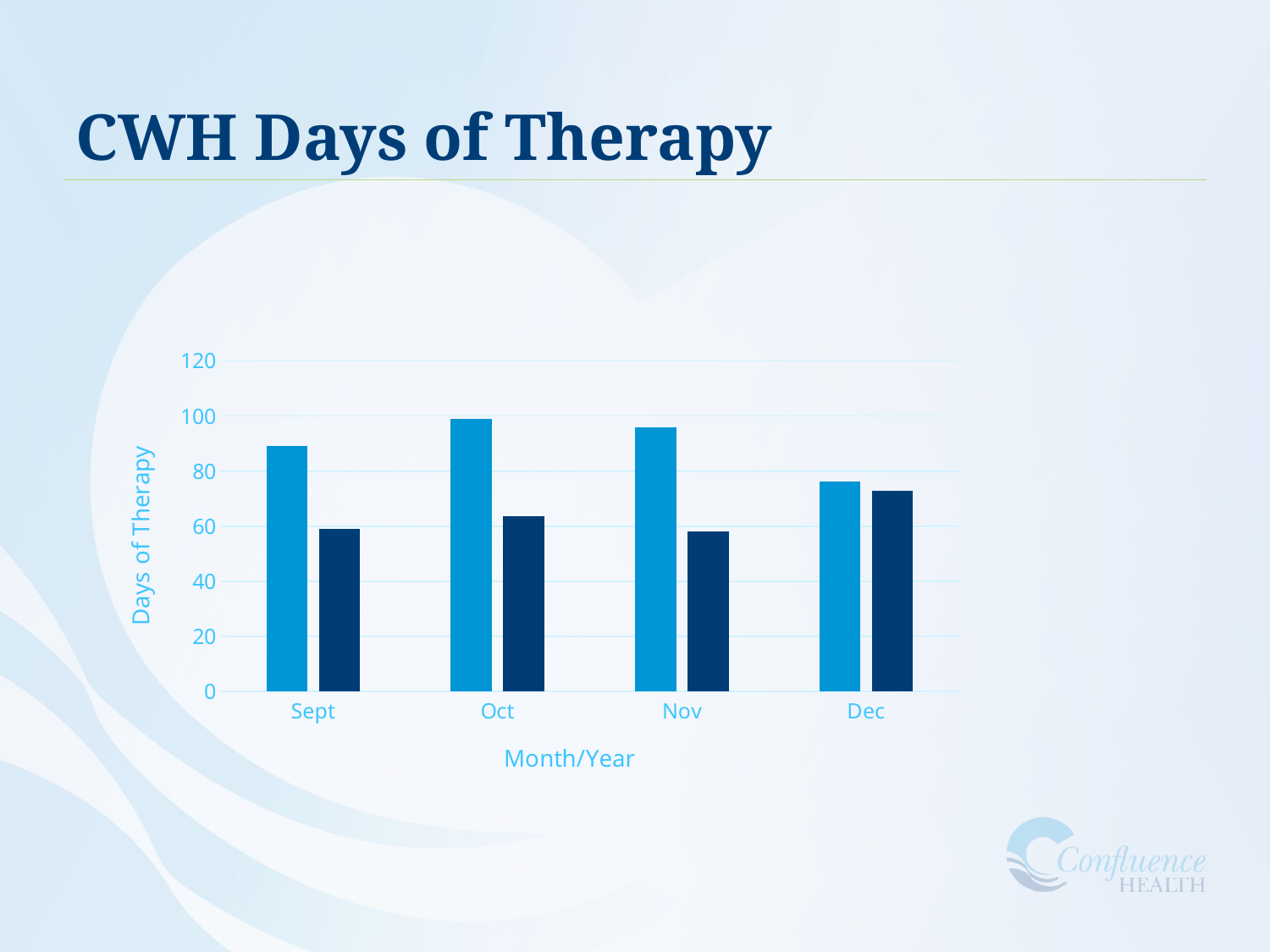
For Nov, which bar is larger, the light blue bar or the dark blue bar? light blue What kind of chart is shown on the slide? bar chart What is the label on the vertical axis of the chart? Days of Therapy In which month is the dark blue bar the highest? Dec Is the light blue bar for Oct greater or less than 80? greater Is the light blue bar for Dec greater or less than 80? less How many bars are plotted for each month in the chart? 2 Do the light blue bars rise or fall from Oct to Dec? fall How many months are shown on the x axis of the chart? 4 In which month is the light blue bar the lowest? Dec Is the dark blue bar for Dec greater or less than 60? greater